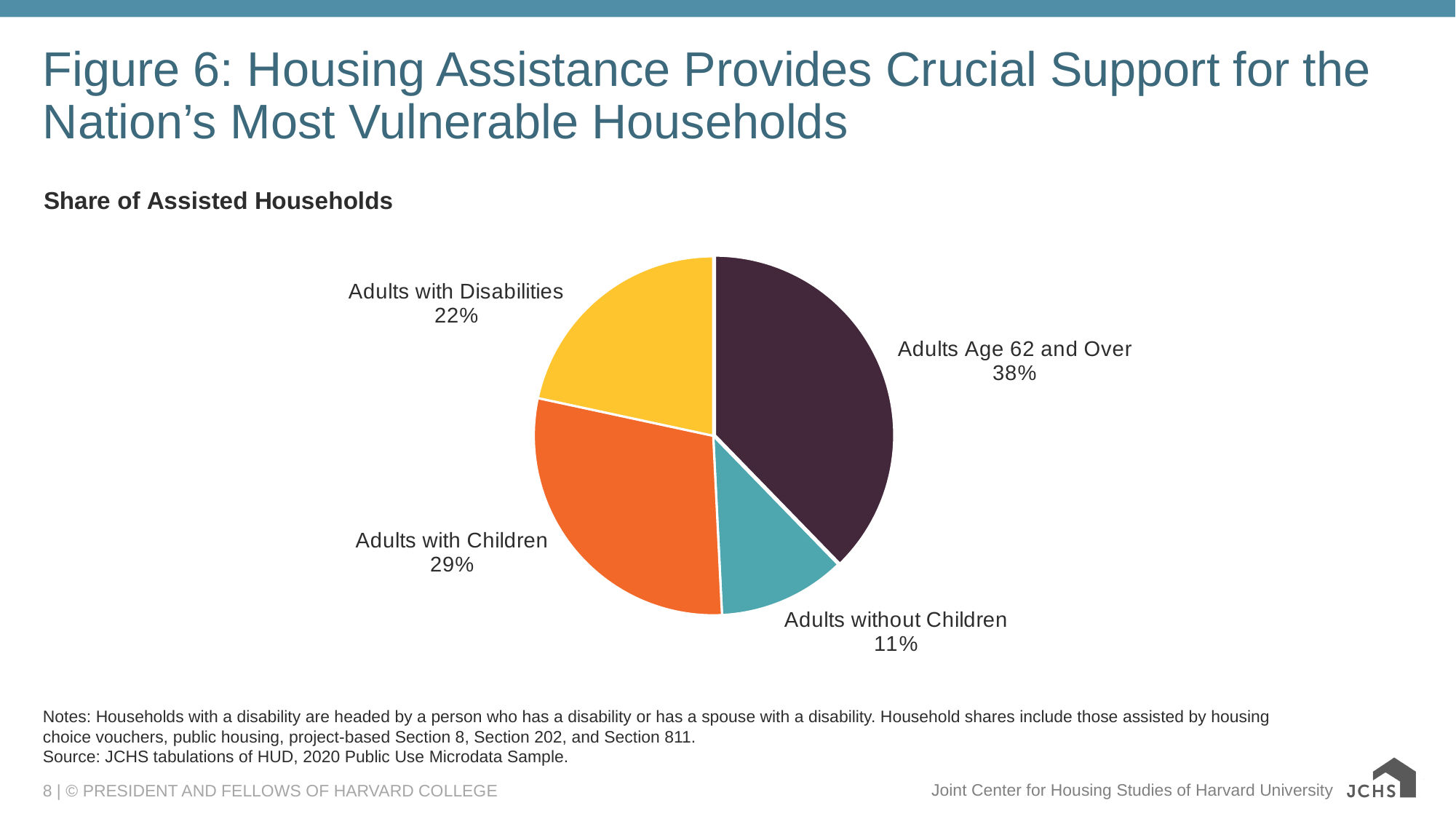
What is the difference in percentage points between the share for Adults Age 62 and Over and the share for Adults without Children? 27 percentage points Which category has the largest share of assisted households? Adults Age 62 and Over Which is larger: the share for Adults with Children or the share for Adults with Disabilities? Adults with Children What is the combined share of Adults with Children and Adults without Children? 40% What is the subtitle of the chart? Share of Assisted Households What share of assisted households are Adults Age 62 and Over? 38% What share of assisted households are Adults without Children? 11% What share of assisted households are Adults with Children? 29% What share of assisted households are Adults with Disabilities? 22% What kind of chart is shown on the slide? Pie chart How many categories are shown in the pie chart? 4 Which category has the smallest share of assisted households? Adults without Children